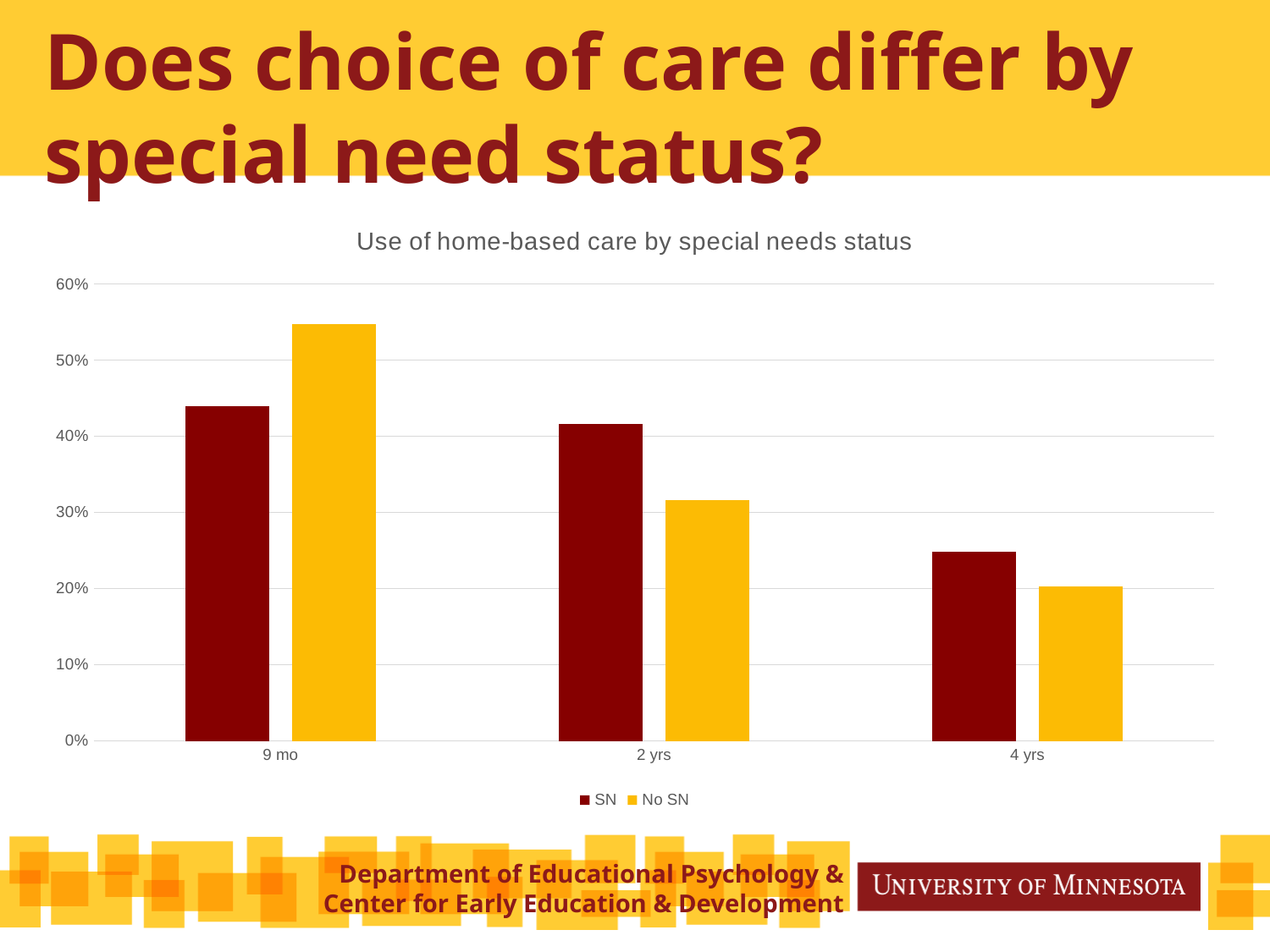
Is the value for SN at 4 yrs greater or less than 20%? greater At 2 yrs, which is larger: SN or No SN? SN How many age categories are shown on the x axis? 3 Do the SN values rise or fall from 9 mo to 4 yrs? fall Which bar is the lowest in the chart? No SN at 4 yrs Is the value for No SN at 9 mo greater or less than 50%? greater Which category has the highest bar in the chart? 9 mo (No SN) Which series is shown in dark red? SN What is the title of the chart? Use of home-based care by special needs status How many series does the legend list? 2 What kind of chart is shown on the slide? Bar chart At 9 mo, which is larger: SN or No SN? No SN